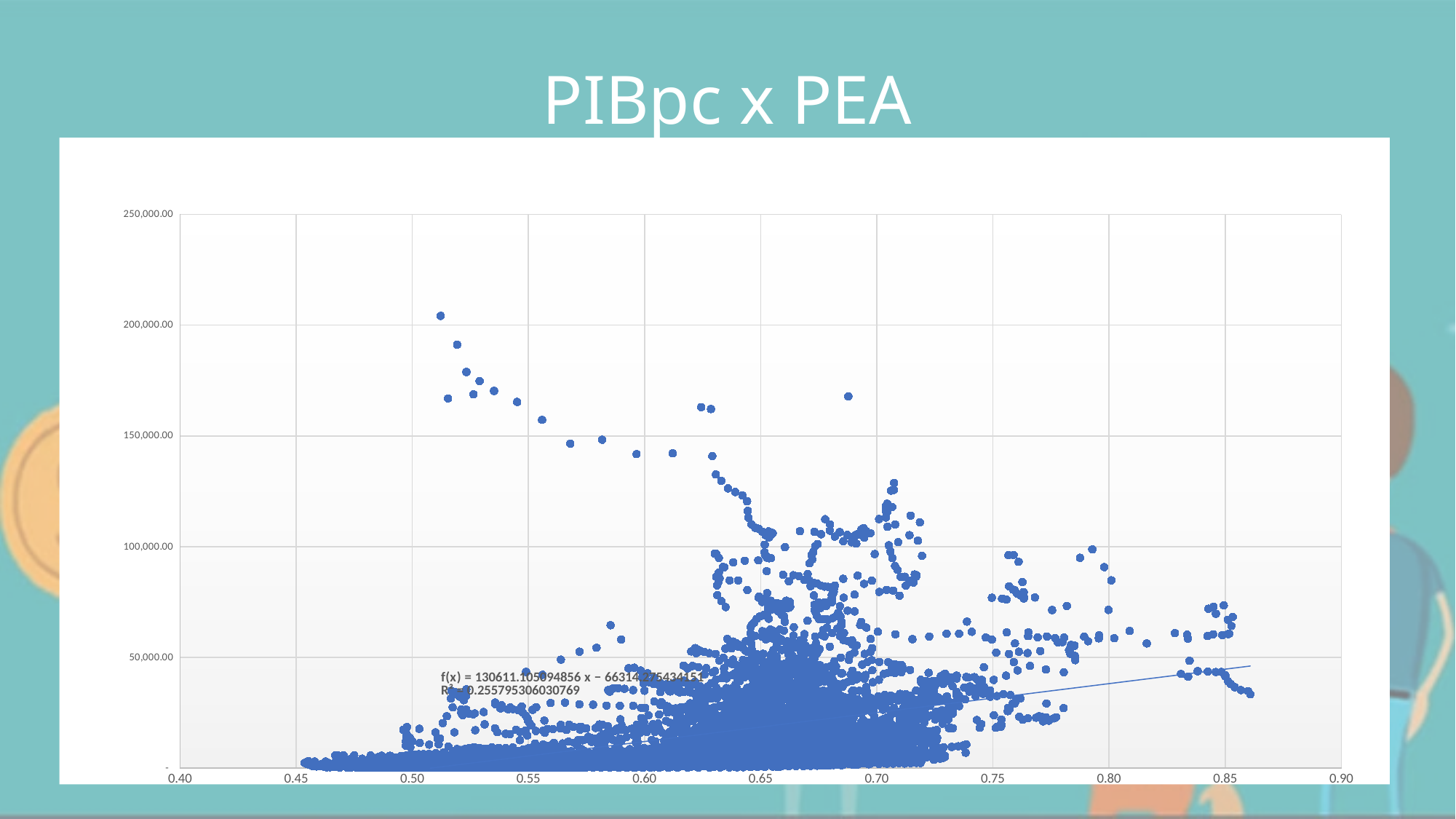
What is the highest value labelled on the vertical axis? 250,000.00 Is the highest plotted point greater or less than 200,000.00 on the vertical axis? greater Is the value of the trendline at x = 0.85 greater or less than 50,000.00? less What is the smallest value labelled on the horizontal axis? 0.40 What kind of chart is shown on the slide? scatter plot What is the title of the chart? PIBpc x PEA What is the slope coefficient in the trendline equation printed on the chart? 130611.105094856 Is the isolated point near x = 0.69 at the top of the cluster greater or less than 150,000.00? greater Does the fitted trendline rise or fall as the x value increases? rises What is the largest value labelled on the horizontal axis? 0.90 What R² value is printed on the chart? 0.255795306030769